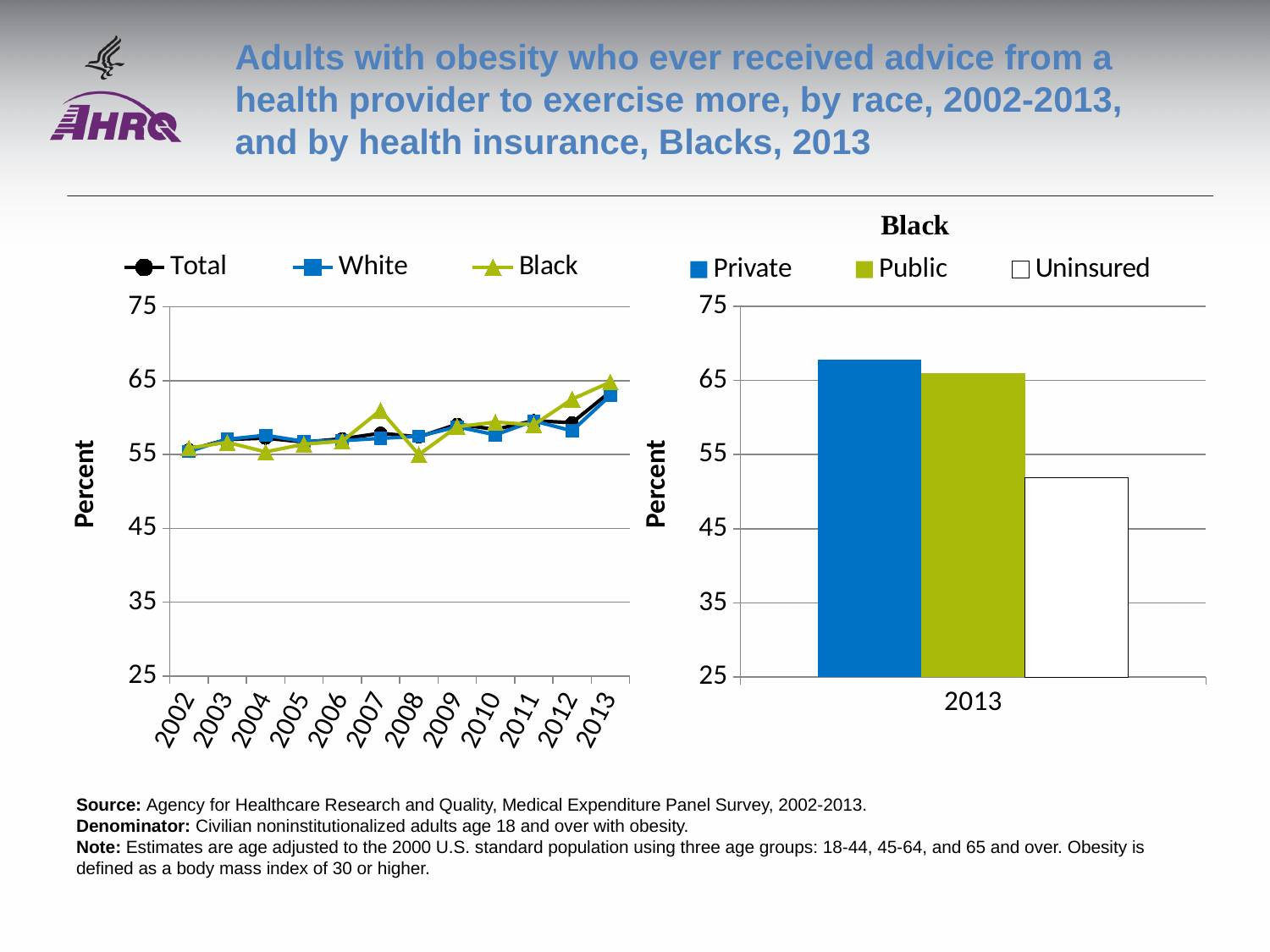
In the right chart titled Black, is the value for Private in 2013 greater or less than 65? greater What kind of chart is the left chart showing Total, White and Black from 2002 to 2013? line chart What kind of chart is the right chart titled Black? bar chart In the right chart titled Black, is the value for Uninsured in 2013 greater or less than 55? less In the right chart titled Black, which is larger in 2013, Private or Uninsured? Private In the right chart titled Black, which insurance group has the highest value in 2013? Private How many series does the legend of the left chart list? 3 How many series does the legend of the right chart titled Black list? 3 In the right chart titled Black, which insurance group has the lowest value in 2013? Uninsured In the left chart, is the value for Black in 2007 greater or less than 55? greater In the left chart, does the Black series generally rise or fall from 2002 to 2013? rise How many years are shown on the x axis of the left chart? 12